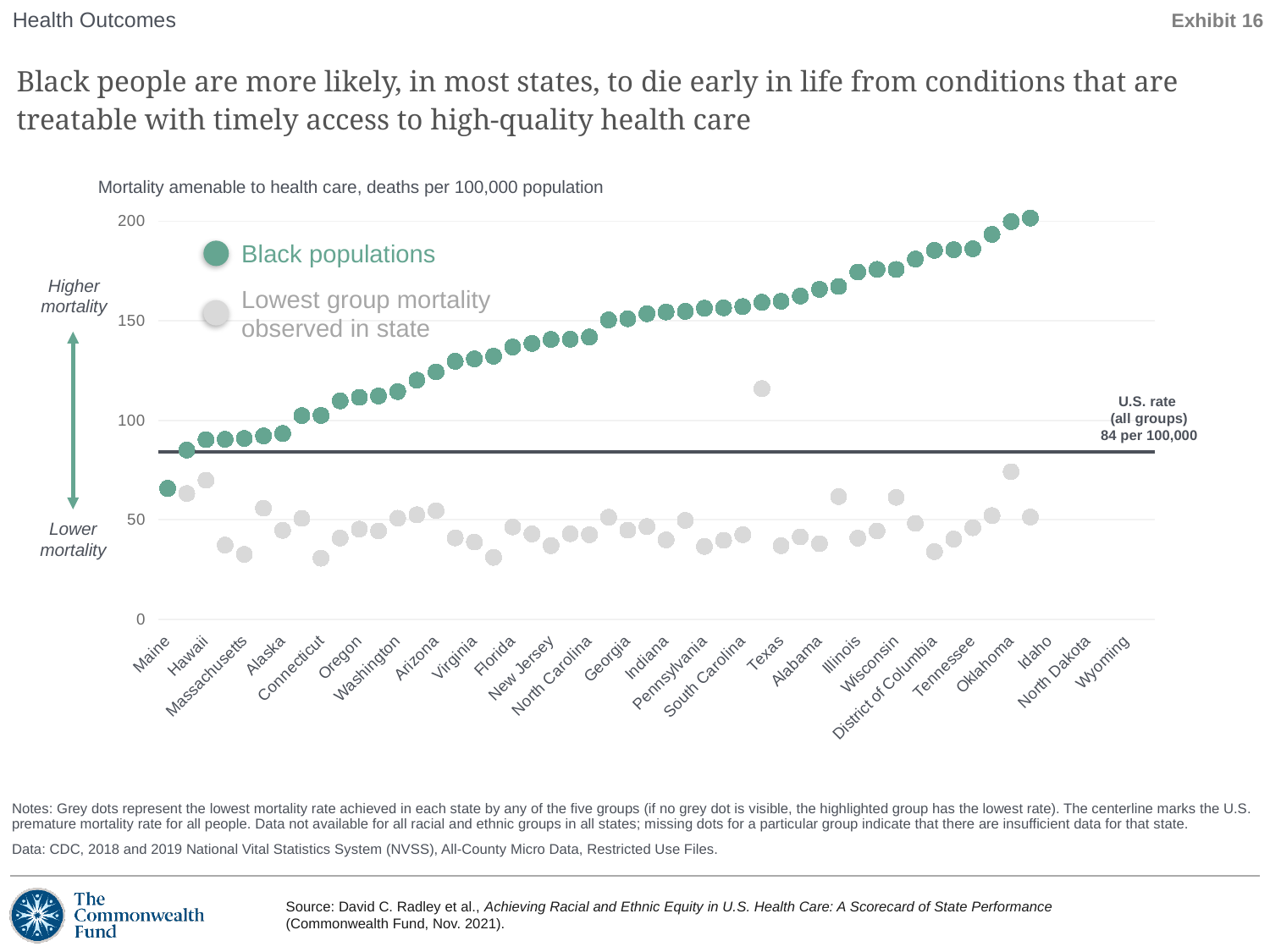
Is the Black population mortality value for Maine greater or less than 50? greater How many series does the chart legend list? 2 What kind of chart is shown on the slide? Dot (scatter) chart Is the Black population mortality value for Maine greater or less than 100? less What U.S. rate (all groups) is marked by the horizontal line on the chart? 84 per 100,000 What is the highest value shown on the y axis? 200 Is the U.S. rate for all groups greater or less than 100 deaths per 100,000? less What is the measure described in the chart's subtitle? Mortality amenable to health care, deaths per 100,000 population Are most of the Black population dots above or below the U.S. rate line? Above What does the grey dot series in the legend represent? Lowest group mortality observed in state Do the values for Black populations rise or fall moving from left to right along the x axis? Rise